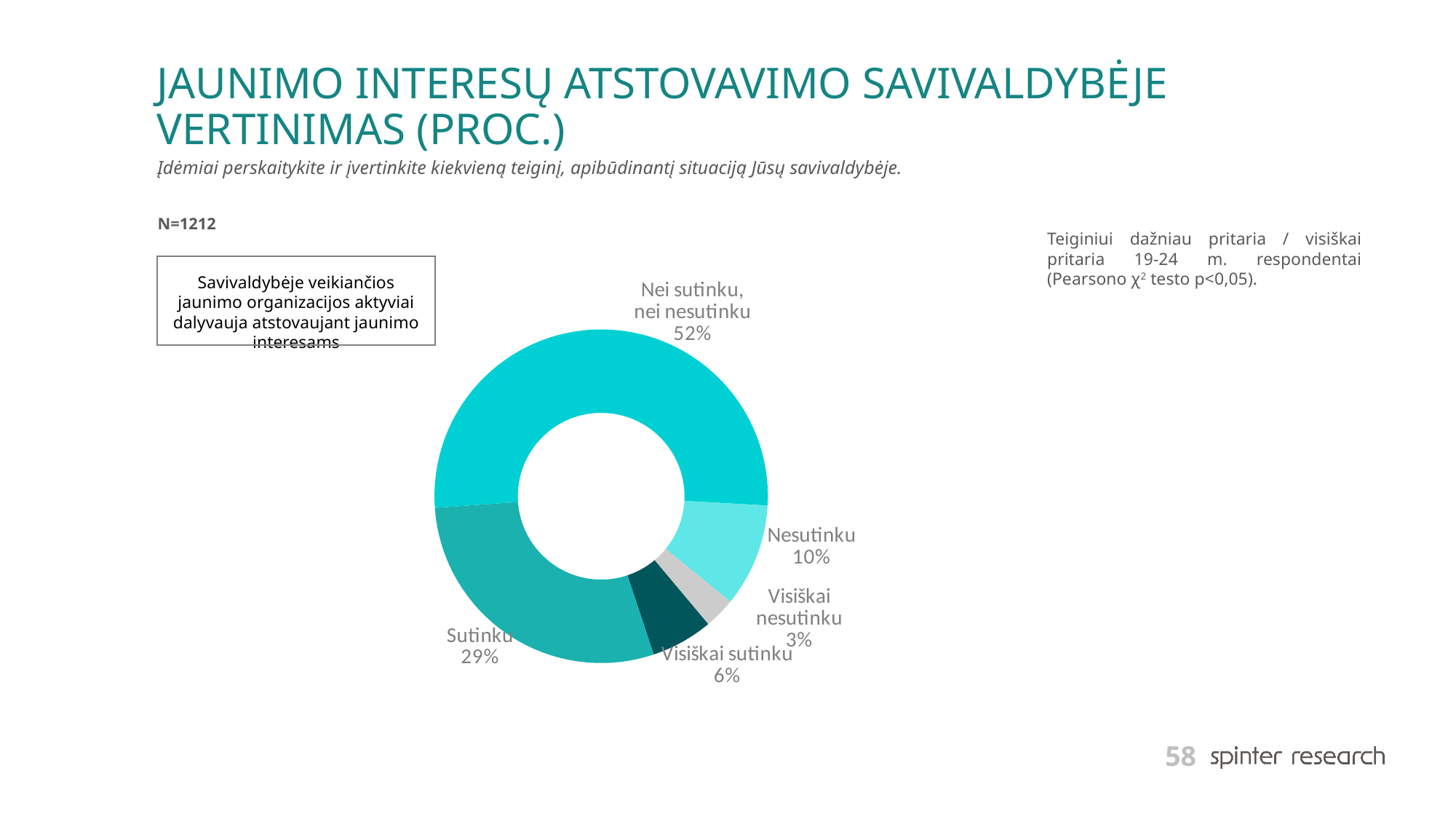
What percentage of respondents answered "Nei sutinku, nei nesutinku"? 52% Which response category has the largest share? Nei sutinku, nei nesutinku What is the difference in percentage points between "Nei sutinku, nei nesutinku" and "Sutinku"? 23 How many response categories are shown in the chart? 5 What type of chart is shown on the slide? Pie chart (doughnut) What percentage of respondents answered "Nesutinku"? 10% What percentage of respondents answered "Visiškai sutinku"? 6% What is the sample size (N) stated on the slide? N=1212 What percentage of respondents answered "Sutinku"? 29% What percentage of respondents answered "Visiškai nesutinku"? 3% Which response category has the smallest share? Visiškai nesutinku Which is larger: the share for "Nesutinku" or the share for "Visiškai sutinku"? Nesutinku